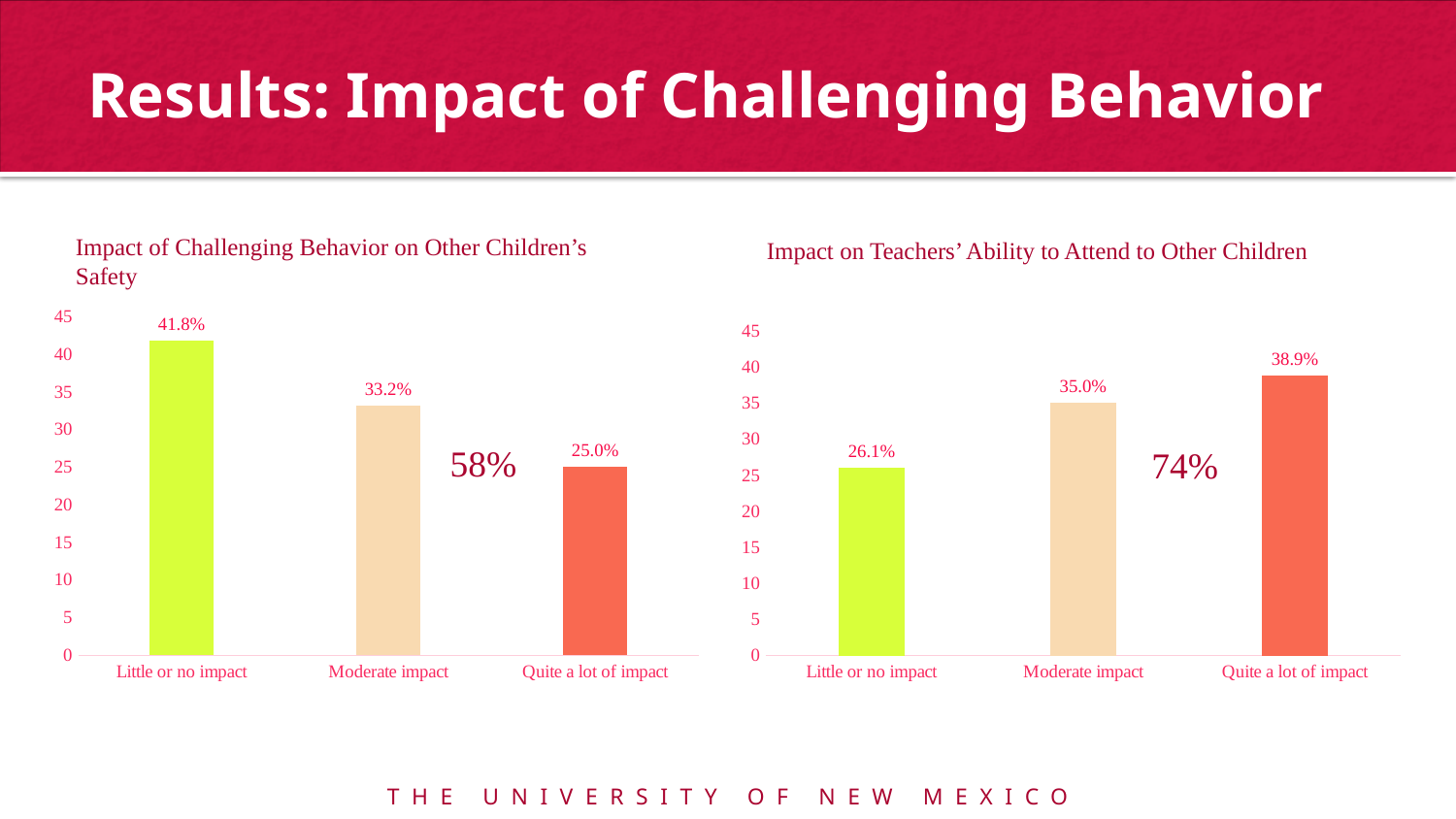
In the chart 'Impact on Teachers' Ability to Attend to Other Children', what is the difference between 'Quite a lot of impact' and 'Little or no impact'? 12.8% In the chart 'Impact on Teachers' Ability to Attend to Other Children', which category has the lowest value? Little or no impact In the chart 'Impact of Challenging Behavior on Other Children's Safety', which is larger: 'Moderate impact' or 'Quite a lot of impact'? Moderate impact In the chart 'Impact of Challenging Behavior on Other Children's Safety', what is the value for 'Quite a lot of impact'? 25.0% In the chart 'Impact on Teachers' Ability to Attend to Other Children', what is the value for 'Little or no impact'? 26.1% What kind of chart is 'Impact of Challenging Behavior on Other Children's Safety'? Bar chart In the chart 'Impact on Teachers' Ability to Attend to Other Children', which category has the highest value? Quite a lot of impact In the chart 'Impact of Challenging Behavior on Other Children's Safety', what is the difference between 'Little or no impact' and 'Moderate impact'? 8.6% How many categories are shown in the chart 'Impact on Teachers' Ability to Attend to Other Children'? 3 In the chart 'Impact of Challenging Behavior on Other Children's Safety', what is the value for 'Little or no impact'? 41.8% In the chart 'Impact of Challenging Behavior on Other Children's Safety', which category has the highest value? Little or no impact In the chart 'Impact on Teachers' Ability to Attend to Other Children', what is the value for 'Moderate impact'? 35.0%